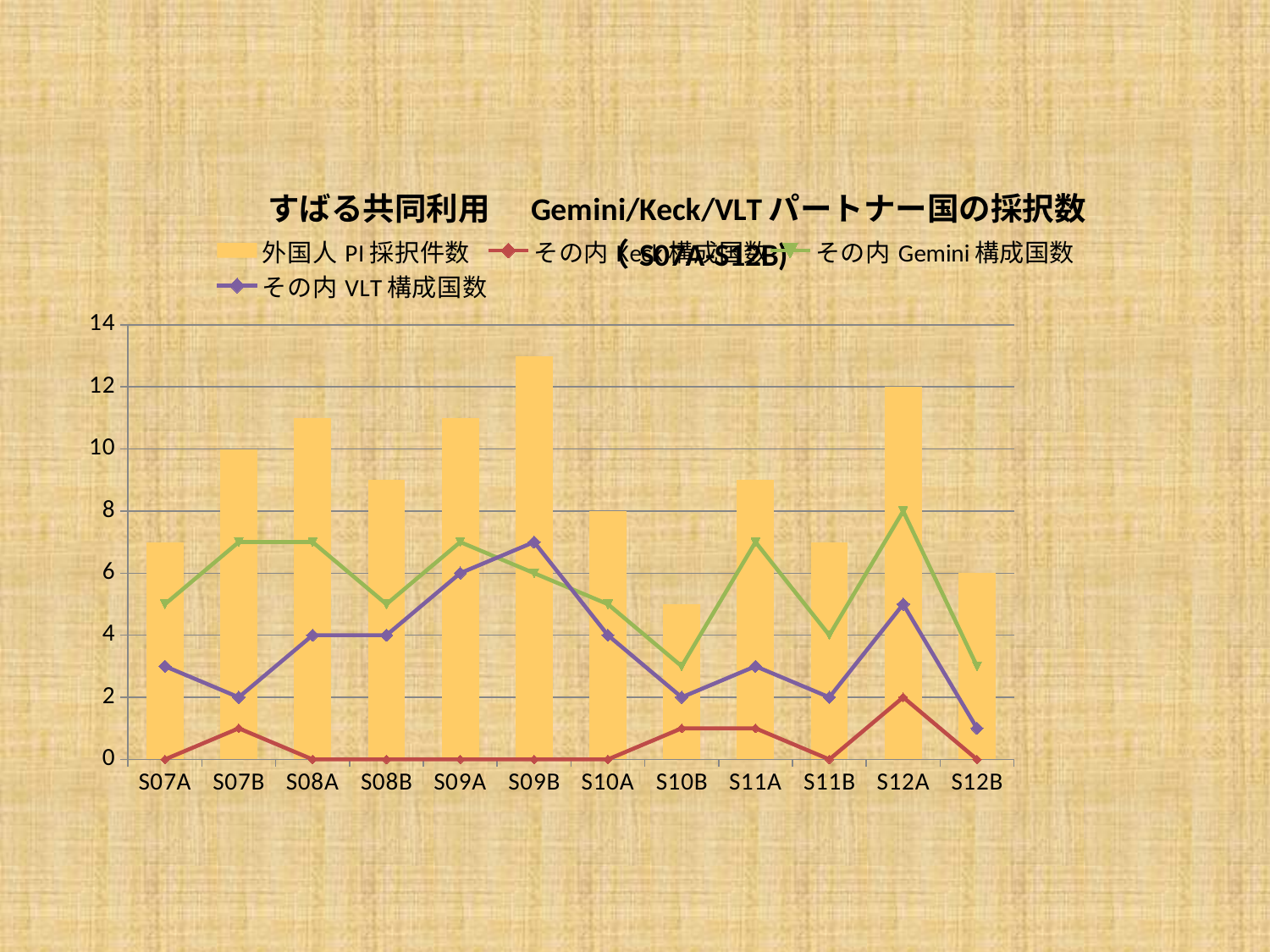
What is the value of 外国人 PI 採択件数 for S07B? 10 Which semester has the highest value of 外国人 PI 採択件数? S09B Which is larger, the 外国人 PI 採択件数 for S12A or for S12B? S12A How many semesters are shown on the x axis? 12 What is the value of その内 Keck 構成国数 for S12A? 2 Which semester has the lowest value of 外国人 PI 採択件数? S10B What is the value of その内 VLT 構成国数 for S09A? 6 Is the value of 外国人 PI 採択件数 for S09B greater or less than 12? greater What is the difference between the 外国人 PI 採択件数 for S12A and for S12B? 6 How many series does the legend list? 4 What is the value of その内 Gemini 構成国数 for S12A? 8 What is the value of 外国人 PI 採択件数 for S12A? 12